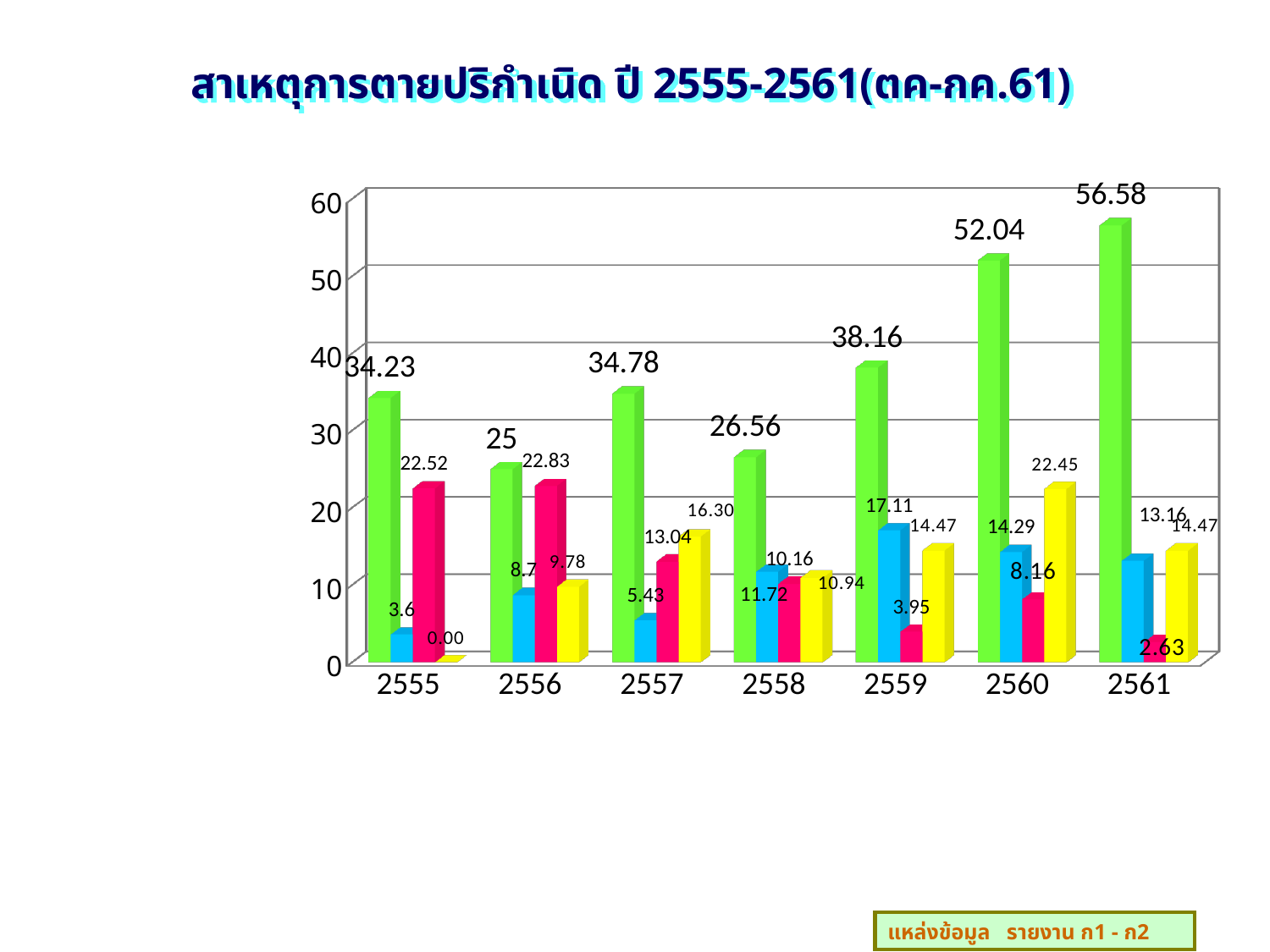
What is the value of the yellow bar for 2555? 0.00 Which is larger for 2558: the blue bar or the pink bar? the blue bar How many year categories are shown on the x axis of the chart? 7 Does the green bar value rise or fall from 2559 to 2561? rise What is the difference between the green bar values for 2561 and 2560? 4.54 What is the value of the green bar for 2561? 56.58 In which year is the green bar highest? 2561 In which year is the pink bar lowest? 2561 What type of chart is shown on the slide? bar chart What is the value of the blue bar for 2559? 17.11 What is the value of the pink bar for 2556? 22.83 What is the value of the yellow bar for 2560? 22.45